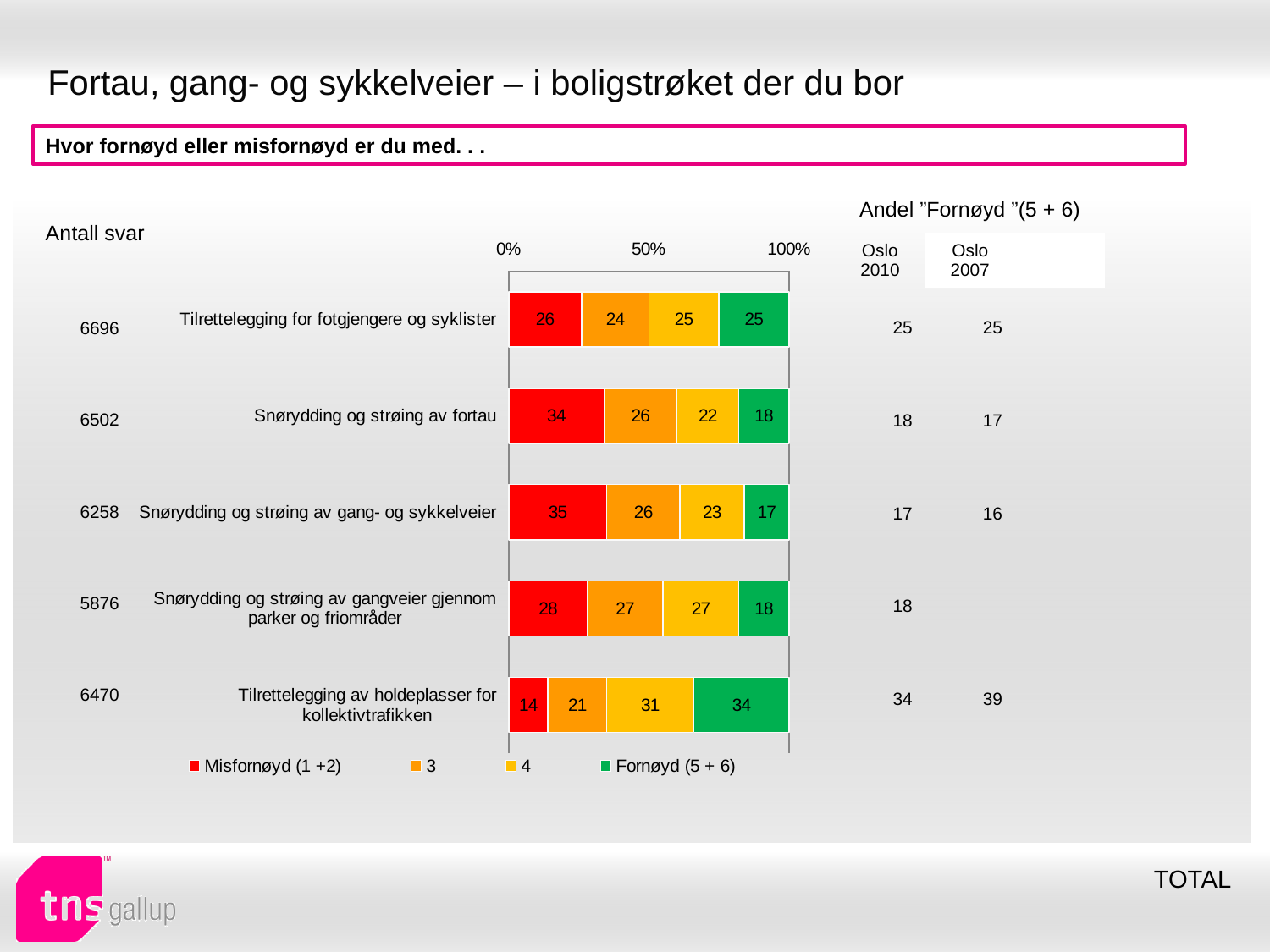
How many series does the legend list? 4 Which category has the highest "Misfornøyd (1 +2)" value? Snørydding og strøing av gang- og sykkelveier What is the "Misfornøyd (1 +2)" value for "Snørydding og strøing av fortau"? 34 What is the "4" value for "Snørydding og strøing av gangveier gjennom parker og friområder"? 27 What kind of chart is shown on the slide? Stacked bar chart Which category has the lowest "Fornøyd (5 + 6)" value? Snørydding og strøing av gang- og sykkelveier How many categories are shown in the chart? 5 What is the difference between the "Misfornøyd (1 +2)" values for "Snørydding og strøing av fortau" and "Tilrettelegging av holdeplasser for kollektivtrafikken"? 20 Which colour represents the "Fornøyd (5 + 6)" series in the legend? Green What is the "Fornøyd (5 + 6)" value for "Tilrettelegging av holdeplasser for kollektivtrafikken"? 34 Which is larger: the "Fornøyd (5 + 6)" value for "Tilrettelegging for fotgjengere og syklister" or for "Snørydding og strøing av fortau"? Tilrettelegging for fotgjengere og syklister What is the total of the stacked bar for "Tilrettelegging for fotgjengere og syklister"? 100